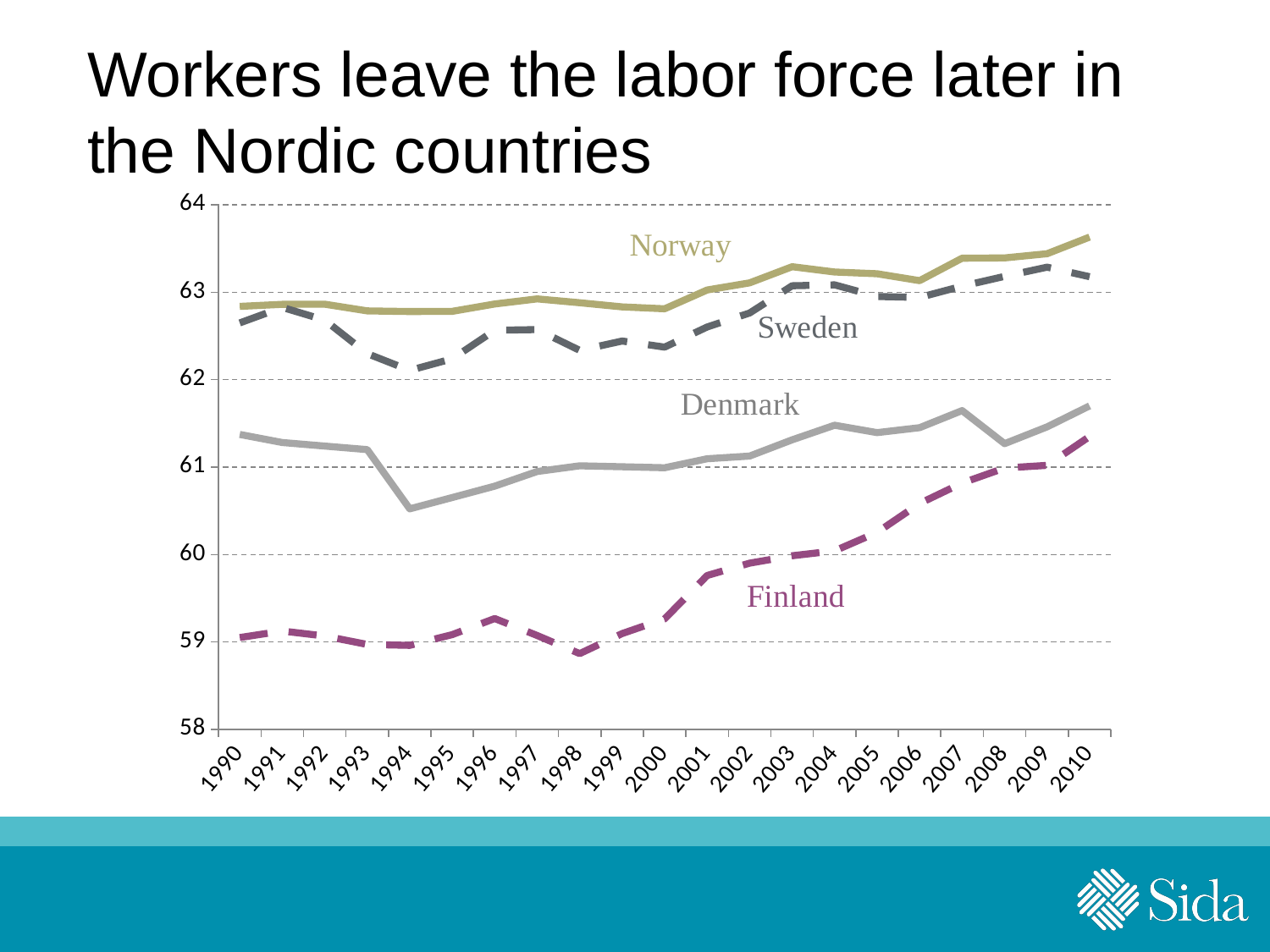
Is the value for Norway in 2010 greater or less than 63? greater Which is larger in 2000, the value for Norway or the value for Finland? Norway Does the line for Finland generally rise or fall from 1990 to 2010? rise Which country has the highest value in 2010? Norway Which is larger in 2005, the value for Sweden or the value for Denmark? Sweden Which country has the lowest value in 1990? Finland Is the value for Finland in 2010 greater or less than 61? greater What is the title of the slide containing the chart? Workers leave the labor force later in the Nordic countries How many countries are plotted as lines on the chart? 4 What kind of chart is shown on the slide? line chart Is the value for Denmark in 1994 greater or less than 61? less How many years are shown along the x axis of the chart? 21